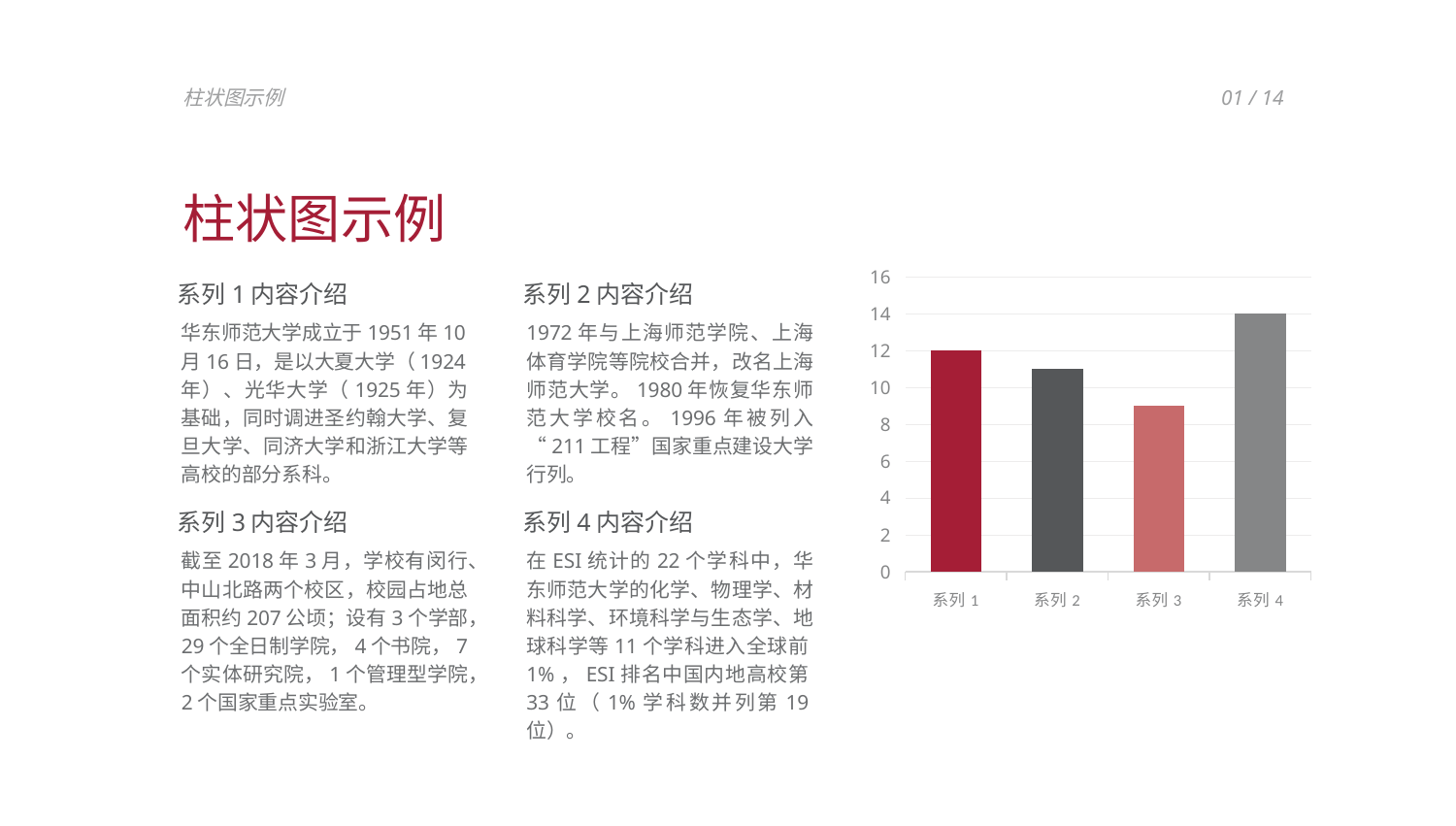
Which category has the highest bar? 系列 4 How many bars (categories) are plotted in the chart? 4 Is the value for 系列 2 greater or less than 10? greater What is the value of the bar for 系列 4? 14 What is the highest value shown on the vertical axis? 16 What type of chart is shown on the slide? Bar chart Is the value for 系列 3 greater or less than 10? less What colour is the bar for 系列 1? Dark red What is the difference between the values for 系列 4 and 系列 1? 2 Which category has the lowest bar? 系列 3 What is the value of the bar for 系列 1? 12 Which is larger, the value for 系列 4 or the value for 系列 3? 系列 4